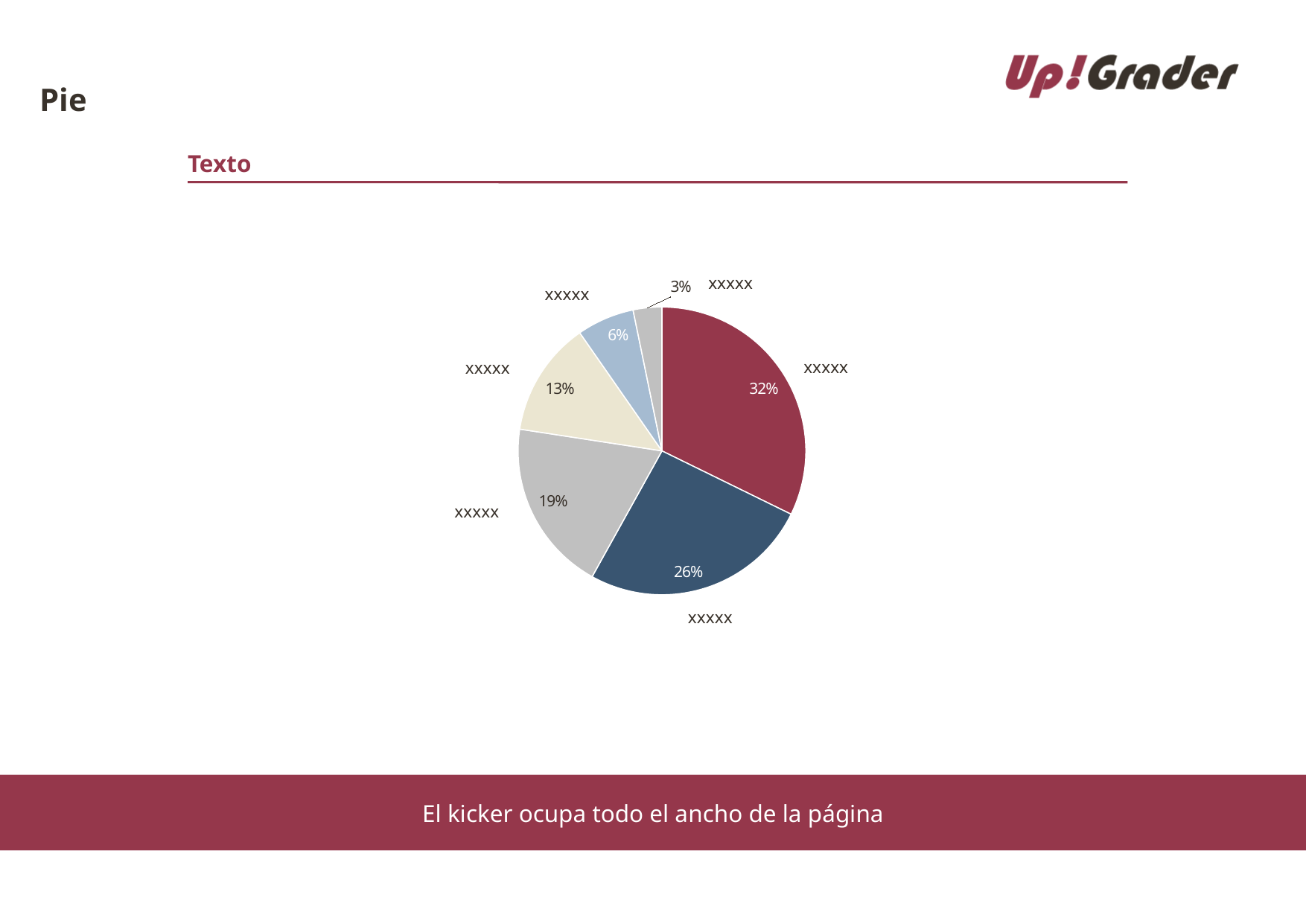
What percentage is shown on the cream-coloured slice of the pie chart? 13% What is the value of the largest slice of the pie chart? 32% What percentage is shown on the dark blue slice of the pie chart? 26% What is the value of the smallest slice of the pie chart? 3% How many slices does the pie chart have? 6 Which slice is larger, the dark blue slice or the light grey slice labelled 19%? the dark blue slice What percentage is shown on the light blue slice of the pie chart? 6% What placeholder text is used for the category labels around the pie chart? xxxxx What is the difference in percentage points between the largest slice (32%) and the smallest slice (3%)? 29 What percentage is shown on the dark red slice of the pie chart? 32% What kind of chart is shown on the slide? pie chart What is the difference in percentage points between the dark red slice (32%) and the dark blue slice (26%)? 6